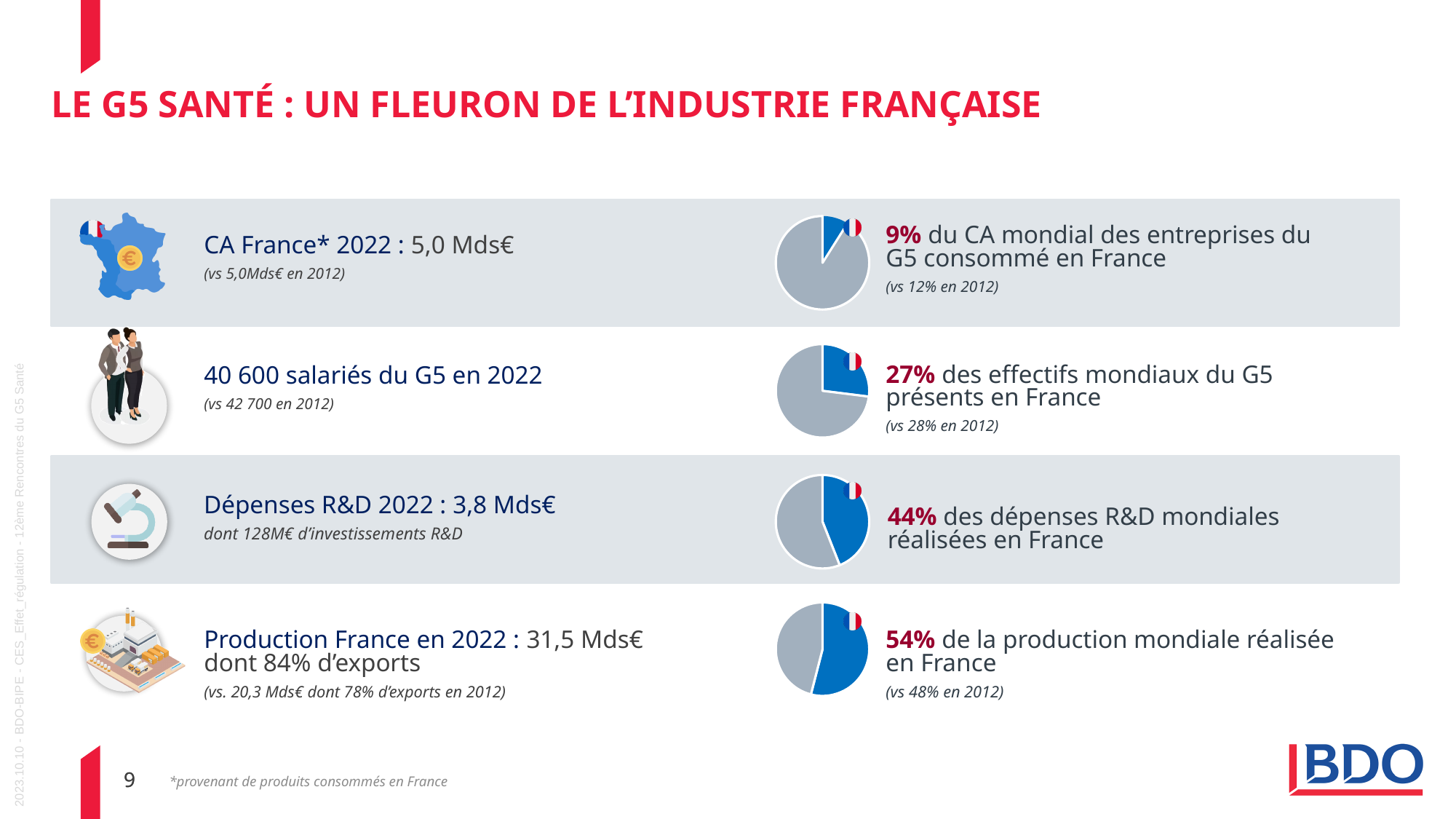
In the bottom pie chart, is the French share of worldwide production greater or less than 50%? greater In the second pie chart, what share of the G5's worldwide workforce is located in France? 27% In the third pie chart, what share of worldwide R&D spending is carried out in France? 44% How many pie charts are on the slide? 4 What is the difference in percentage points between the French share of worldwide production (54%) and the French share of worldwide R&D spending (44%)? 10 percentage points Which is larger: the French share of the G5's worldwide workforce or the French share of worldwide R&D spending? R&D spending (44%) What colour is used for the France slice in each pie chart? Blue What kind of charts are shown on the right side of the slide? Pie charts In the bottom pie chart, what share of worldwide production is carried out in France? 54% Which of the four pie charts shows the smallest French share? CA mondial consommé en France (9%) Which of the four pie charts shows the largest French share? Production mondiale réalisée en France (54%)